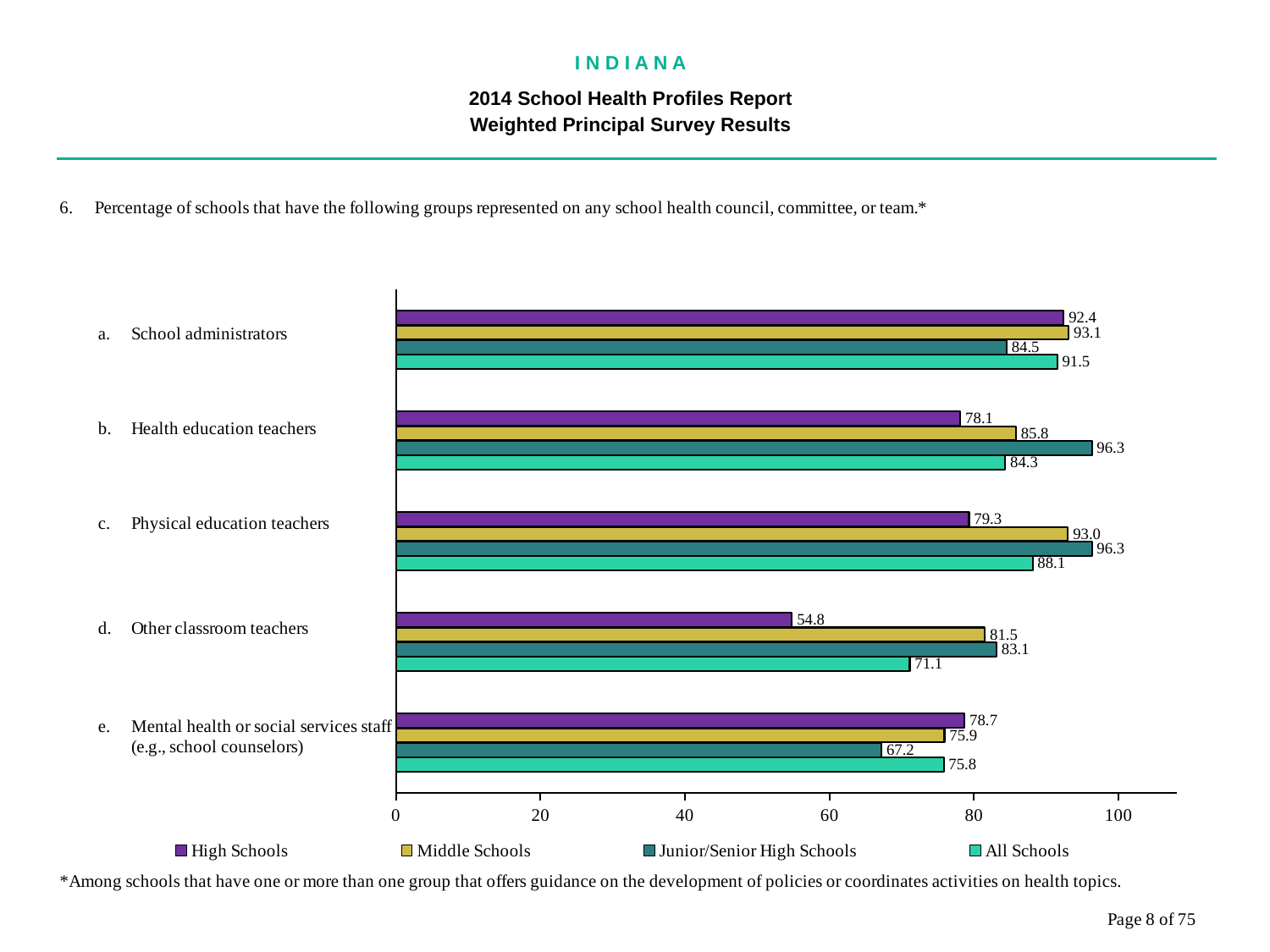
What is the value for All Schools for Other classroom teachers? 71.1 What is the value for Middle Schools for Mental health or social services staff (e.g., school counselors)? 75.9 How many series does the legend list? 4 How many categories are shown on the chart? 5 What kind of chart is shown on the slide? bar chart What is the difference between the Junior/Senior High Schools and High Schools values for Other classroom teachers? 28.3 What is the value for High Schools for School administrators? 92.4 For Physical education teachers, which is larger: the Middle Schools value or the High Schools value? Middle Schools What is the value for Junior/Senior High Schools for Health education teachers? 96.3 Is the value for High Schools for Other classroom teachers greater or less than 60? less Which category has the highest value for All Schools? School administrators Which category has the lowest value for High Schools? Other classroom teachers